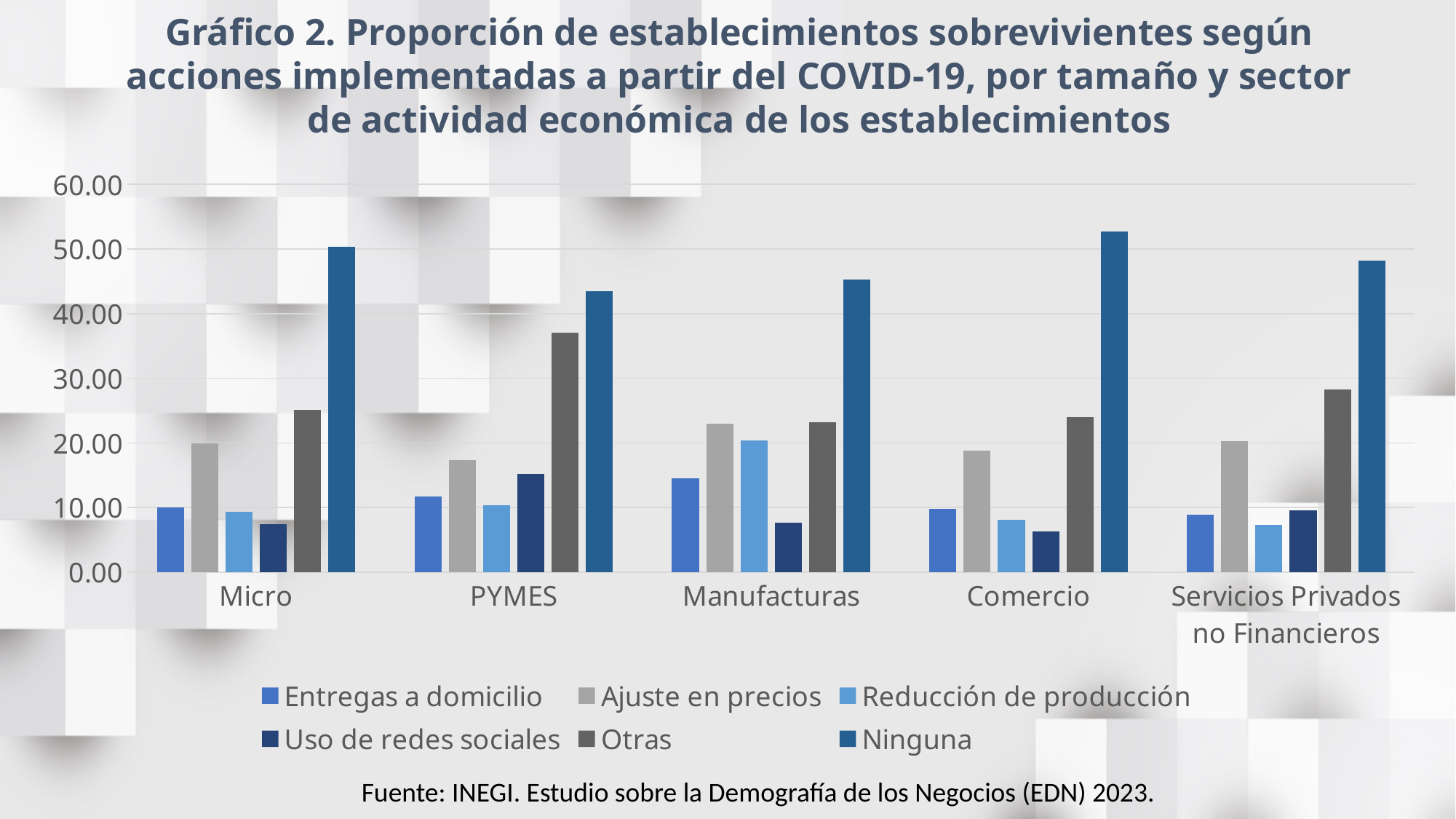
Within PYMES, which is larger: Otras or Ajuste en precios? Otras Is the value for Ninguna in Micro greater or less than 40.00? greater What source is cited below the chart? INEGI. Estudio sobre la Demografía de los Negocios (EDN) 2023. How many categories are shown along the x axis? 5 Which category has the lowest value for Ninguna? PYMES Which is larger: Reducción de producción in Manufacturas or Reducción de producción in Micro? Manufacturas What kind of chart is shown on the slide? bar chart How many series does the legend list? 6 Is the value for Uso de redes sociales in Comercio greater or less than 10.00? less Within Micro, which series has the highest value? Ninguna Which category has the highest value for Ninguna? Comercio Is the value for Otras in PYMES greater or less than 30.00? greater